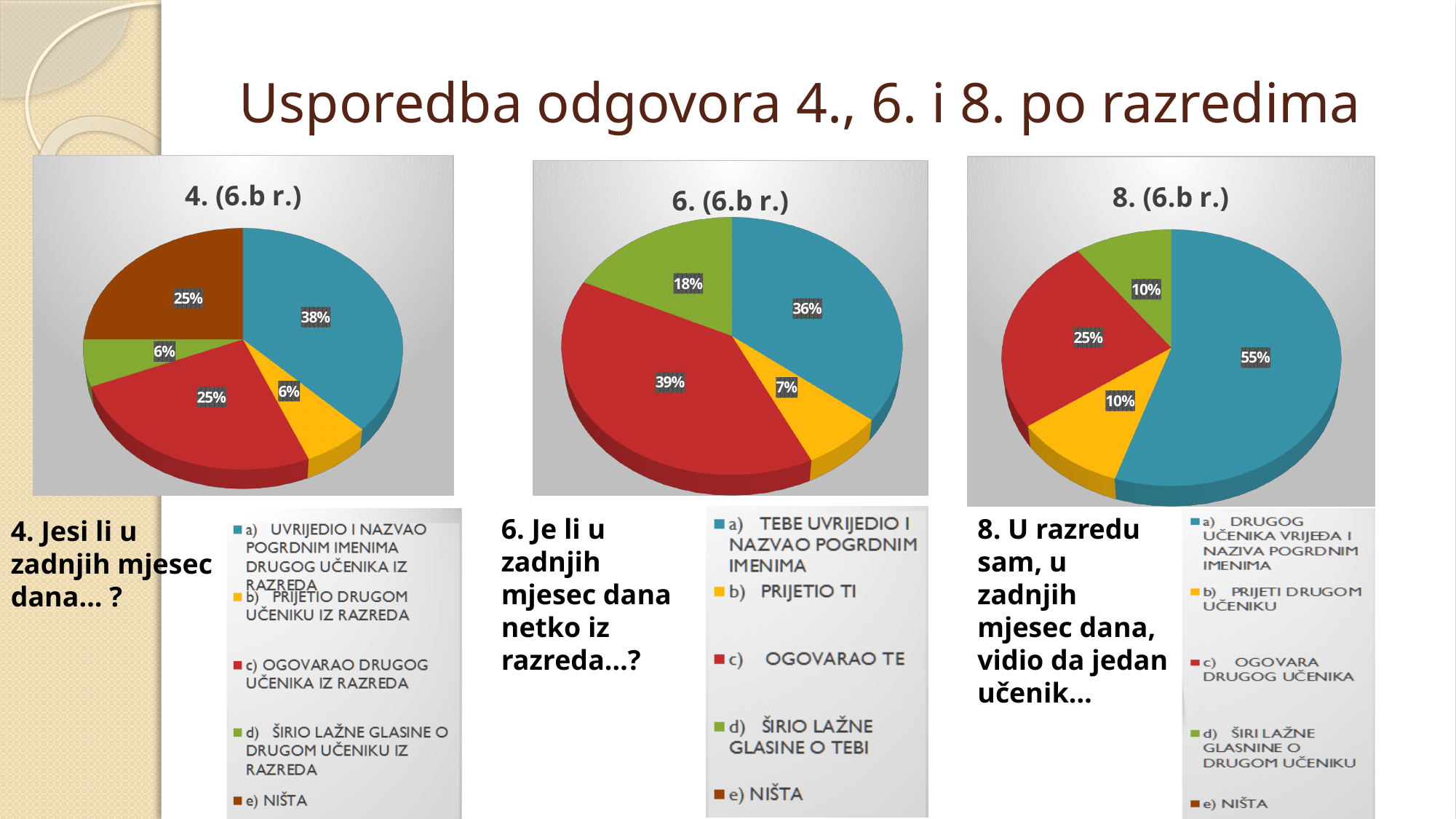
In the chart titled "6. (6.b r.)", which legend entry has the smallest labelled slice? b) PRIJETIO TI How many entries does the legend of the chart titled "8. (6.b r.)" list? 5 In the chart titled "8. (6.b r.)", which legend entry has the largest slice? a) DRUGOG UČENIKA VRIJEĐA I NAZIVA POGRDNIM IMENIMA What type of chart is used for the three charts on the slide? Pie chart In the chart titled "6. (6.b r.)", what is the difference between the c) OGOVARAO TE slice and the a) TEBE UVRIJEDIO I NAZVAO POGRDNIM IMENIMA slice? 3% In the chart titled "6. (6.b r.)", what percentage is shown for the slice labelled c) OGOVARAO TE? 39% In the chart titled "8. (6.b r.)", what percentage is shown for the slice labelled a) DRUGOG UČENIKA VRIJEĐA I NAZIVA POGRDNIM IMENIMA? 55% In the chart titled "4. (6.b r.)", which is larger: the a) slice or the c) OGOVARAO DRUGOG UČENIKA IZ RAZREDA slice? a) UVRIJEDIO I NAZVAO POGRDNIM IMENIMA DRUGOG UČENIKA IZ RAZREDA In the chart titled "6. (6.b r.)", what percentage is shown for the slice labelled d) ŠIRIO LAŽNE GLASINE O TEBI? 18% In the chart titled "4. (6.b r.)", what percentage is shown for the slice labelled a) UVRIJEDIO I NAZVAO POGRDNIM IMENIMA DRUGOG UČENIKA IZ RAZREDA? 38% In the chart titled "8. (6.b r.)", what is the difference between the a) slice and the c) OGOVARA DRUGOG UČENIKA slice? 30% In the chart titled "4. (6.b r.)", what percentage is shown for the slice labelled e) NIŠTA? 25%